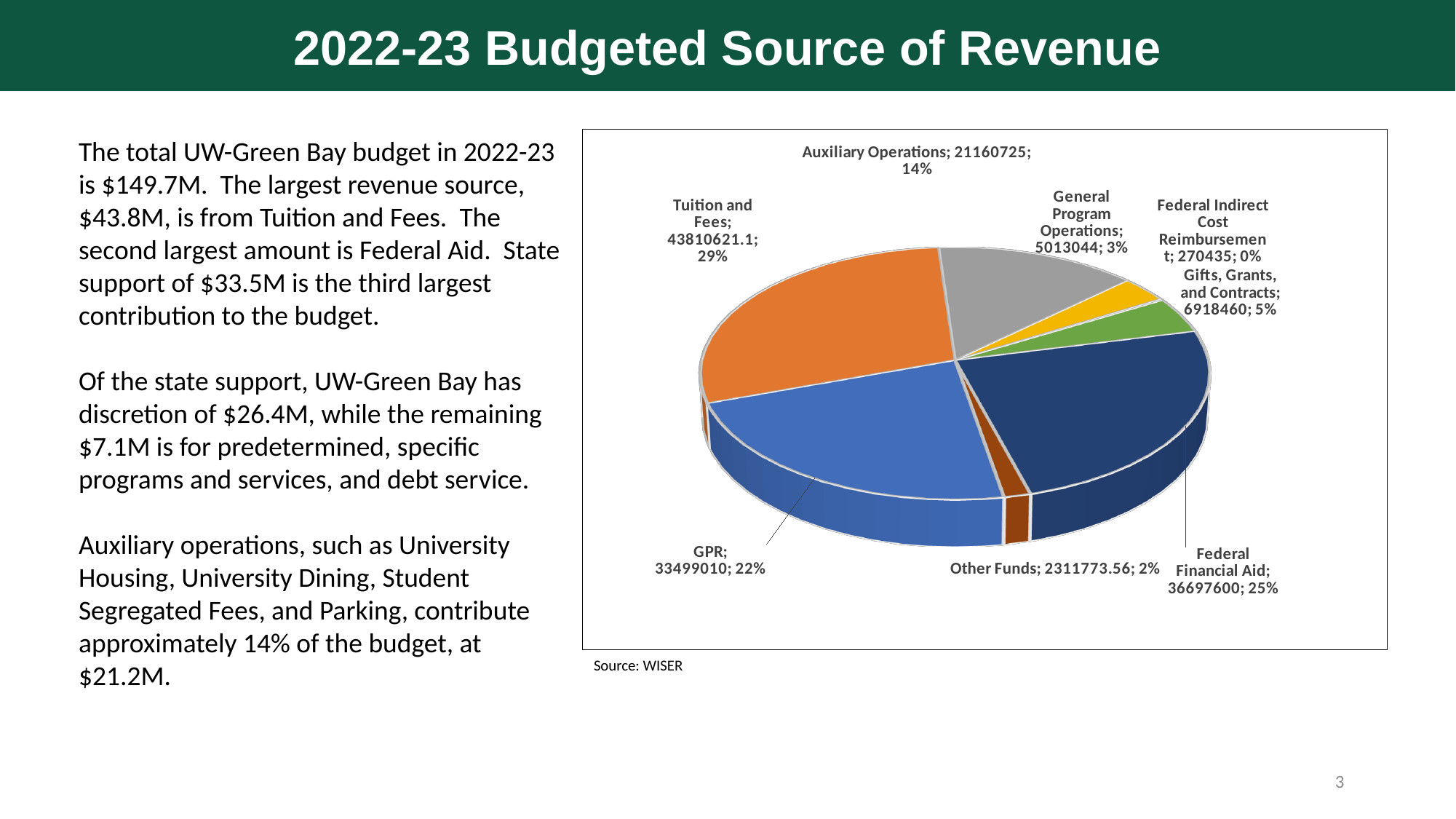
What share of the pie does Auxiliary Operations represent? 14% What kind of chart is shown on the slide? pie chart What is the source cited below the chart? WISER What is the value for Federal Financial Aid in the pie chart? 36697600 Which category has the largest slice of the pie chart? Tuition and Fees What is the difference between the values for Federal Financial Aid and GPR? 3198590 Which is larger in the pie chart, Federal Financial Aid or GPR? Federal Financial Aid What share of the pie does Gifts, Grants, and Contracts represent? 5% Which category has the smallest slice of the pie chart? Federal Indirect Cost Reimbursement What is the value for Tuition and Fees in the pie chart? 43810621.1 What is the value for GPR in the pie chart? 33499010 How many categories does the pie chart show? 8